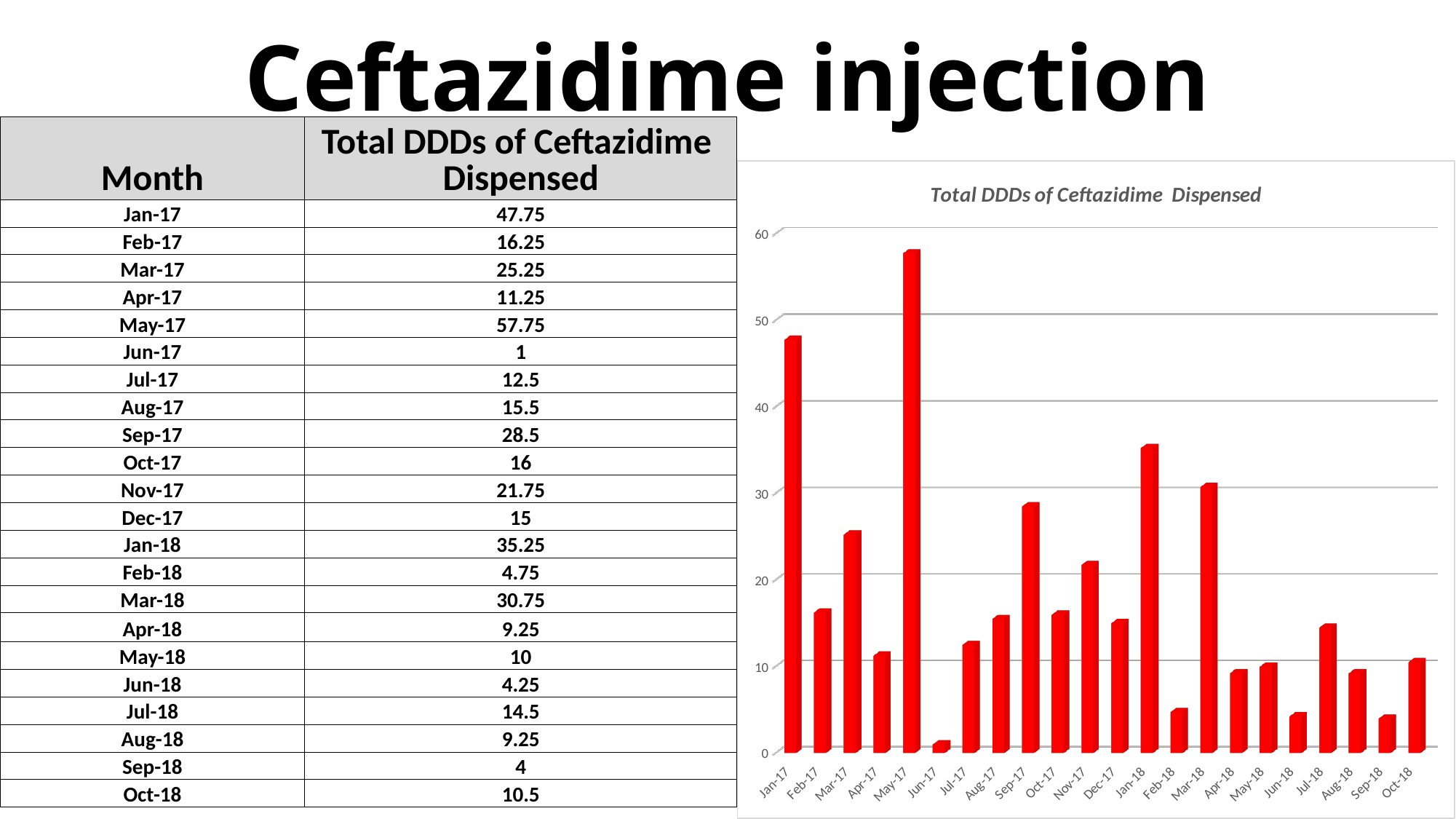
Is the value for Jan-17 greater or less than 40? greater What type of chart is shown on the slide? bar chart What is the total DDDs of Ceftazidime dispensed in May-17? 57.75 How many months are plotted in the chart? 22 What is the title of the chart? Total DDDs of Ceftazidime Dispensed Which month has the lowest total DDDs of Ceftazidime dispensed? Jun-17 Which month has the larger value, Mar-18 or Sep-17? Mar-18 Which month has the highest total DDDs of Ceftazidime dispensed? May-17 Is the value for Sep-18 greater or less than 10? less What is the total DDDs of Ceftazidime dispensed in Oct-18? 10.5 What is the difference in total DDDs dispensed between Jan-17 and Feb-17? 31.5 What is the total DDDs of Ceftazidime dispensed in Jan-18? 35.25